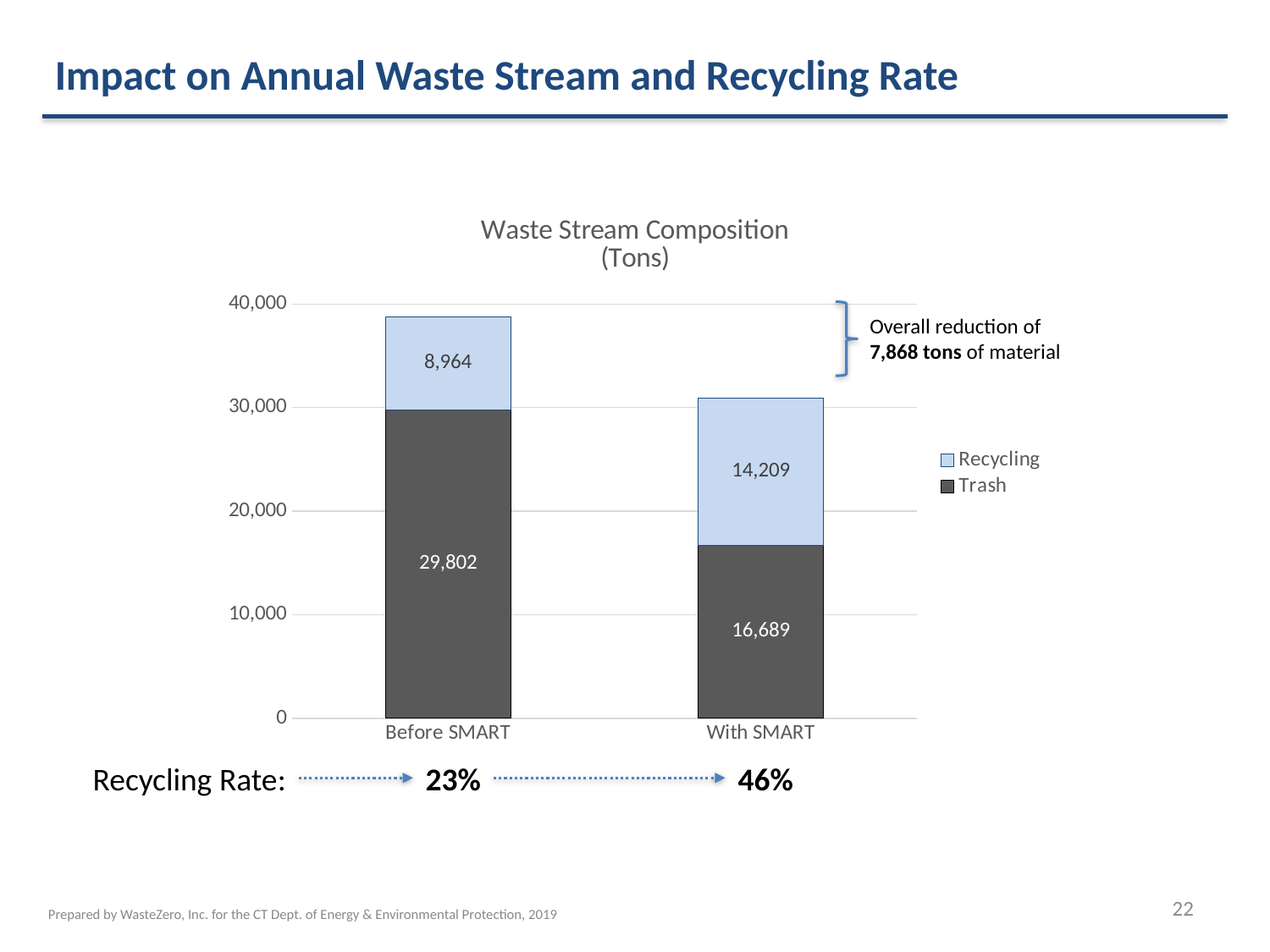
What is the total of the stacked bar for Before SMART? 38,766 What is the title of the chart? Waste Stream Composition (Tons) What is the difference in Recycling between With SMART and Before SMART? 5,245 What is the Recycling value for Before SMART? 8,964 Which category has the larger Recycling value, Before SMART or With SMART? With SMART What kind of chart is shown on the slide? Stacked bar chart What is the Trash value for Before SMART? 29,802 What is the total of the stacked bar for With SMART? 30,898 What is the Recycling value for With SMART? 14,209 By how much does the Trash value decrease from Before SMART to With SMART? 13,113 How many series does the legend list? 2 What is the Trash value for With SMART? 16,689